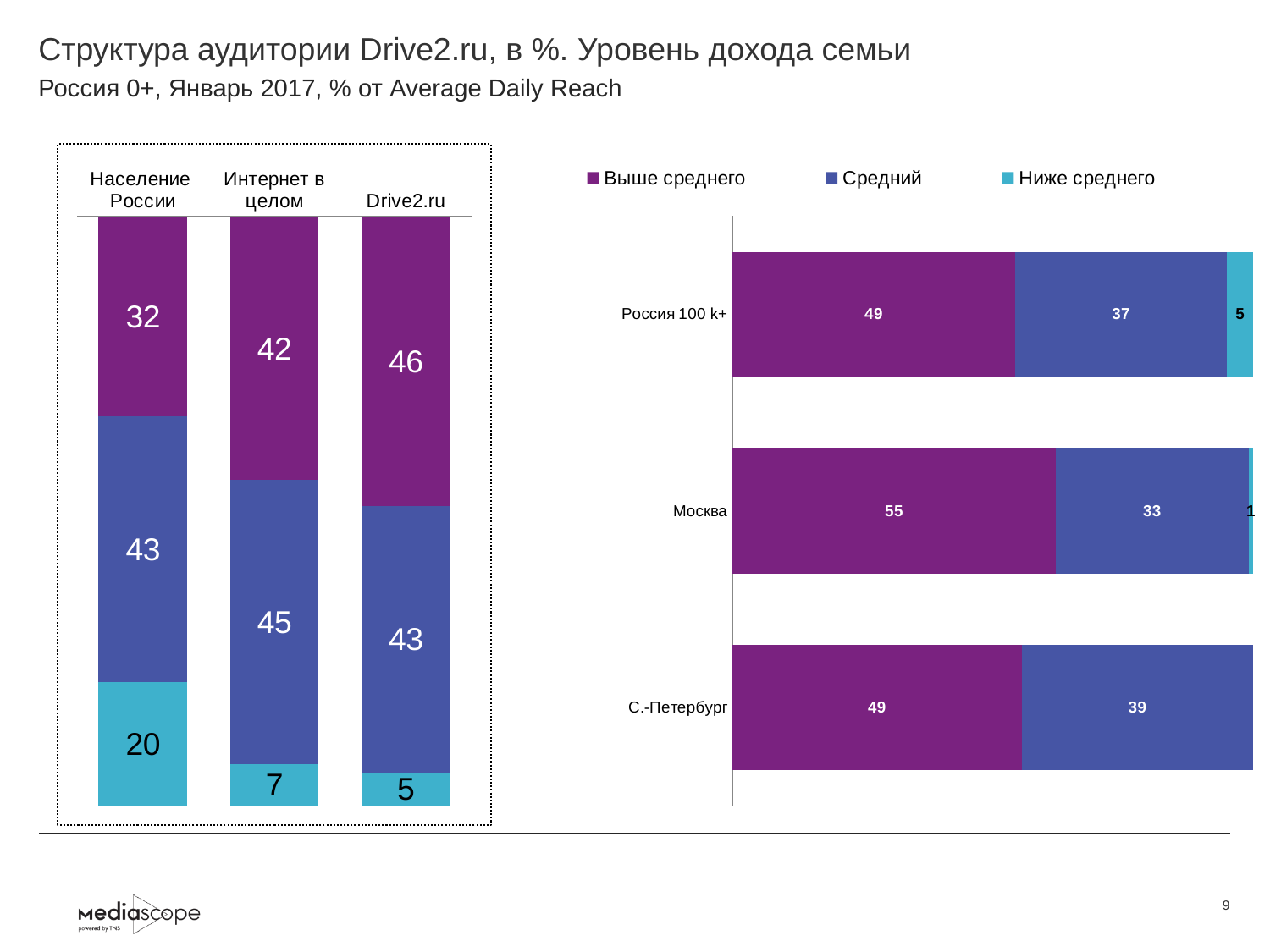
In the left chart, what is the value of the 'Ниже среднего' (cyan) segment for Население России? 20 In the right chart, which category has the highest 'Выше среднего' value? Москва What type of chart is the right chart? Stacked bar chart How many series does the legend of the right chart list? 3 In the left chart, which category has the largest 'Ниже среднего' (cyan) segment? Население России In the left chart, what is the value of the 'Средний' (blue) segment for Интернет в целом? 45 In the left chart, what is the difference between the 'Выше среднего' values for Drive2.ru and Население России? 14 In the left chart, how many categories are shown? 3 In the right chart, is the 'Средний' value larger for Россия 100 k+ or for С.-Петербург? С.-Петербург In the right chart, what is the 'Средний' value for С.-Петербург? 39 In the right chart, what is the 'Выше среднего' value for Москва? 55 In the left chart, what is the value of the 'Выше среднего' (purple) segment for Drive2.ru? 46